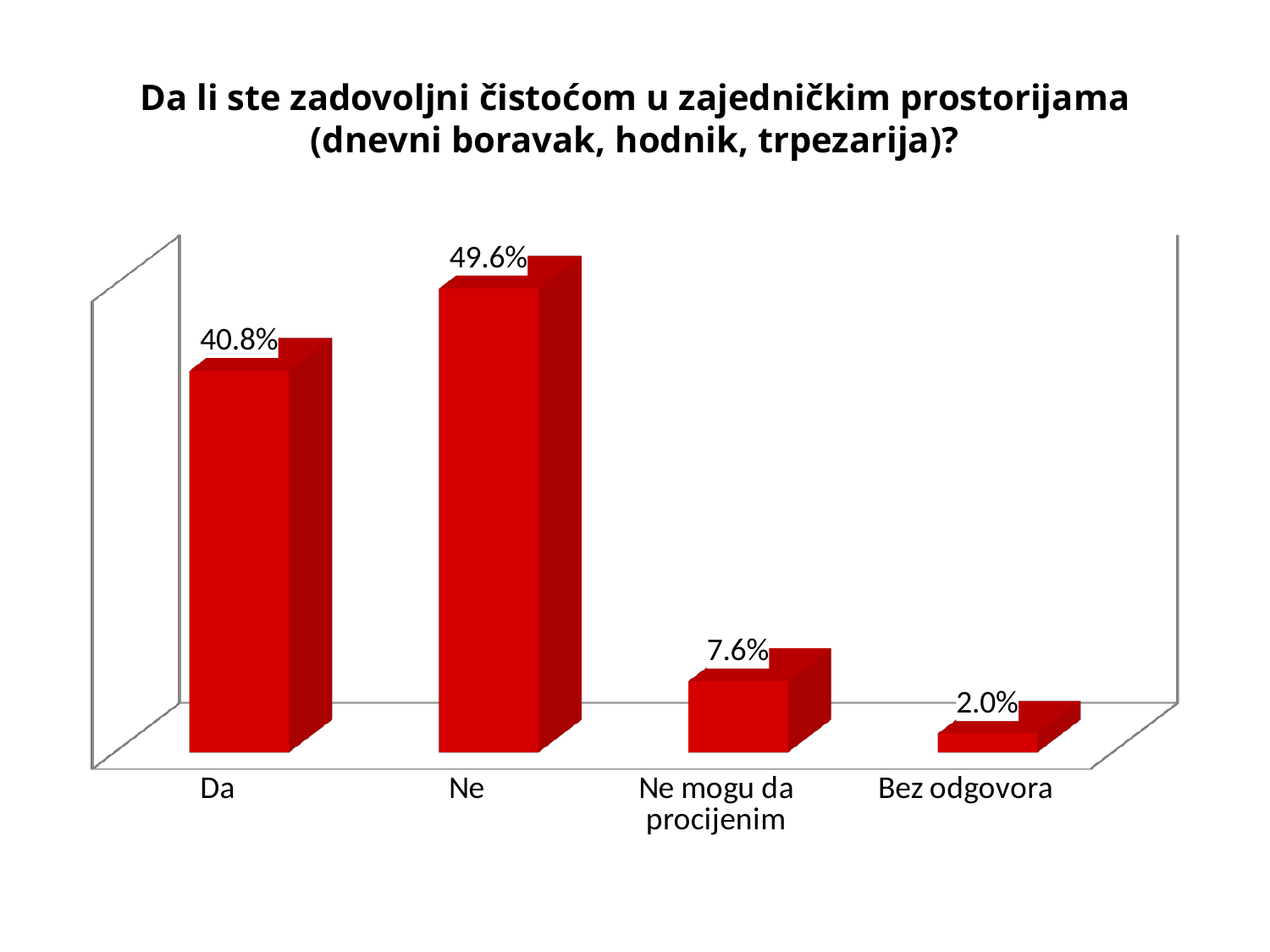
How many categories are shown on the x axis? 4 Which category has the lowest value? Bez odgovora What is the difference between the values for "Ne mogu da procijenim" and "Bez odgovora"? 5.6% What is the value for "Ne mogu da procijenim"? 7.6% Which is larger, the value for "Da" or the value for "Ne mogu da procijenim"? Da What is the value for "Bez odgovora"? 2.0% What colour are the bars in the chart? Red What kind of chart is shown on the slide? Bar chart Which category has the highest value? Ne What is the difference between the values for "Ne" and "Da"? 8.8% What is the value for "Da"? 40.8% What is the value for "Ne"? 49.6%